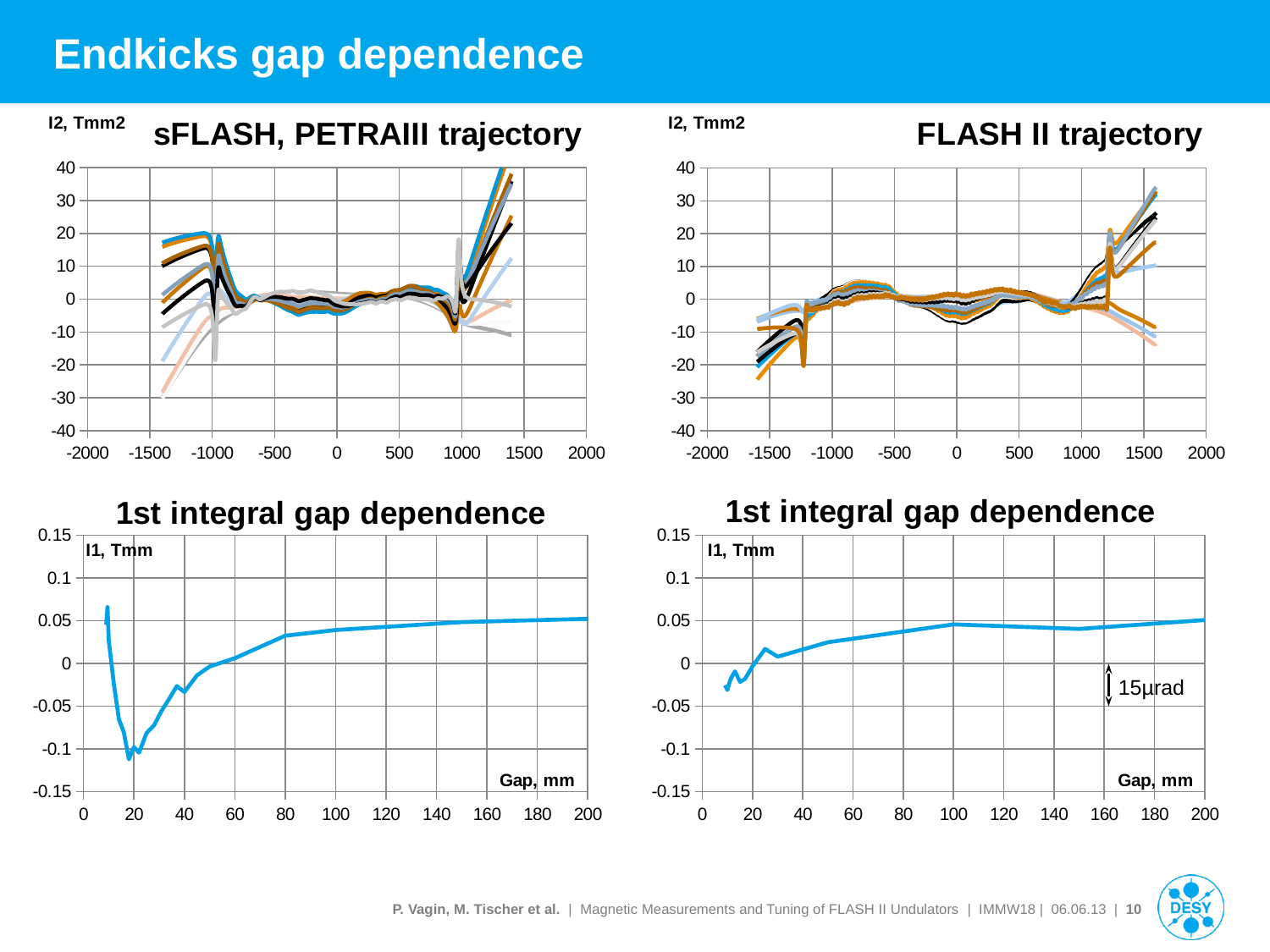
In the bottom-left '1st integral gap dependence' chart, is the value at a gap of 20 mm greater or less than -0.05? less In the bottom-left '1st integral gap dependence' chart, is the value at a gap of 200 mm greater or less than 0? greater In the bottom-left '1st integral gap dependence' chart, is the value at a gap of 20 mm greater or less than 0? less What kind of chart is the top-right 'FLASH II trajectory' chart? line chart What is the x-axis label of the bottom-right '1st integral gap dependence' chart? Gap, mm What is the title of the top-left chart? sFLASH, PETRAIII trajectory What kind of chart is the bottom-left '1st integral gap dependence' chart? line chart In the bottom-left '1st integral gap dependence' chart, which is larger: the value at a gap of 20 mm or at a gap of 200 mm? 200 mm In the bottom-right '1st integral gap dependence' chart, which is larger: the value at a gap of 10 mm or at a gap of 200 mm? 200 mm In the bottom-left '1st integral gap dependence' chart, does the value rise or fall as the gap increases from 20 mm to 200 mm? rise